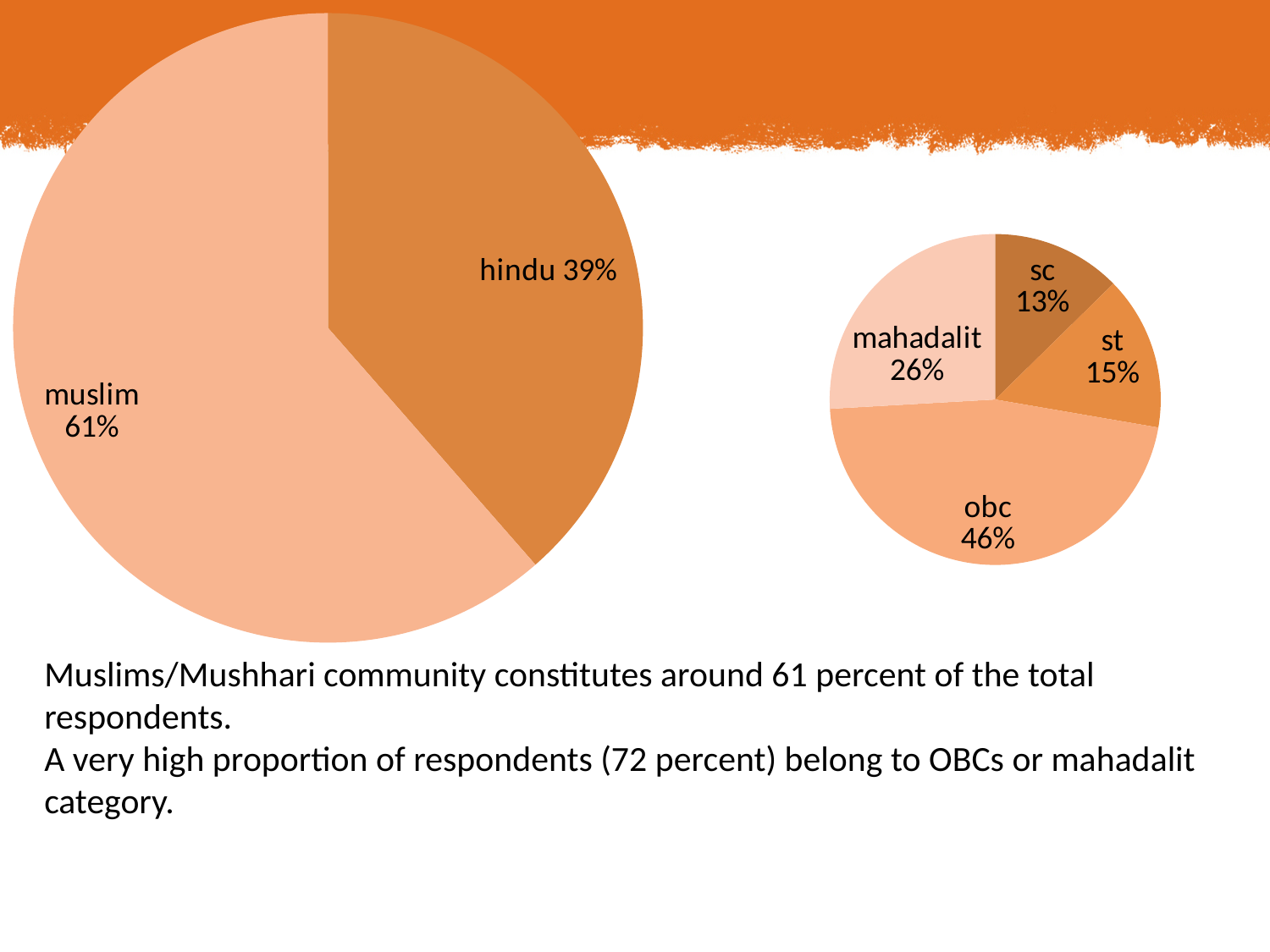
In the left pie chart, which slice is larger, muslim or hindu? muslim In the right pie chart, what share is sc? 13% In the right pie chart, what is the difference in percentage points between obc and mahadalit? 20 In the right pie chart, what share is mahadalit? 26% In the left pie chart, what share of respondents is hindu? 39% In the right pie chart, which category has the largest share? obc What type of chart is the left chart? pie chart In the left pie chart, what is the difference in percentage points between the muslim and hindu shares? 22 In the right pie chart, what share is obc? 46% In the left pie chart, what share of respondents is muslim? 61% In the right pie chart, which category has the smallest share? sc How many slices does the right pie chart have? 4